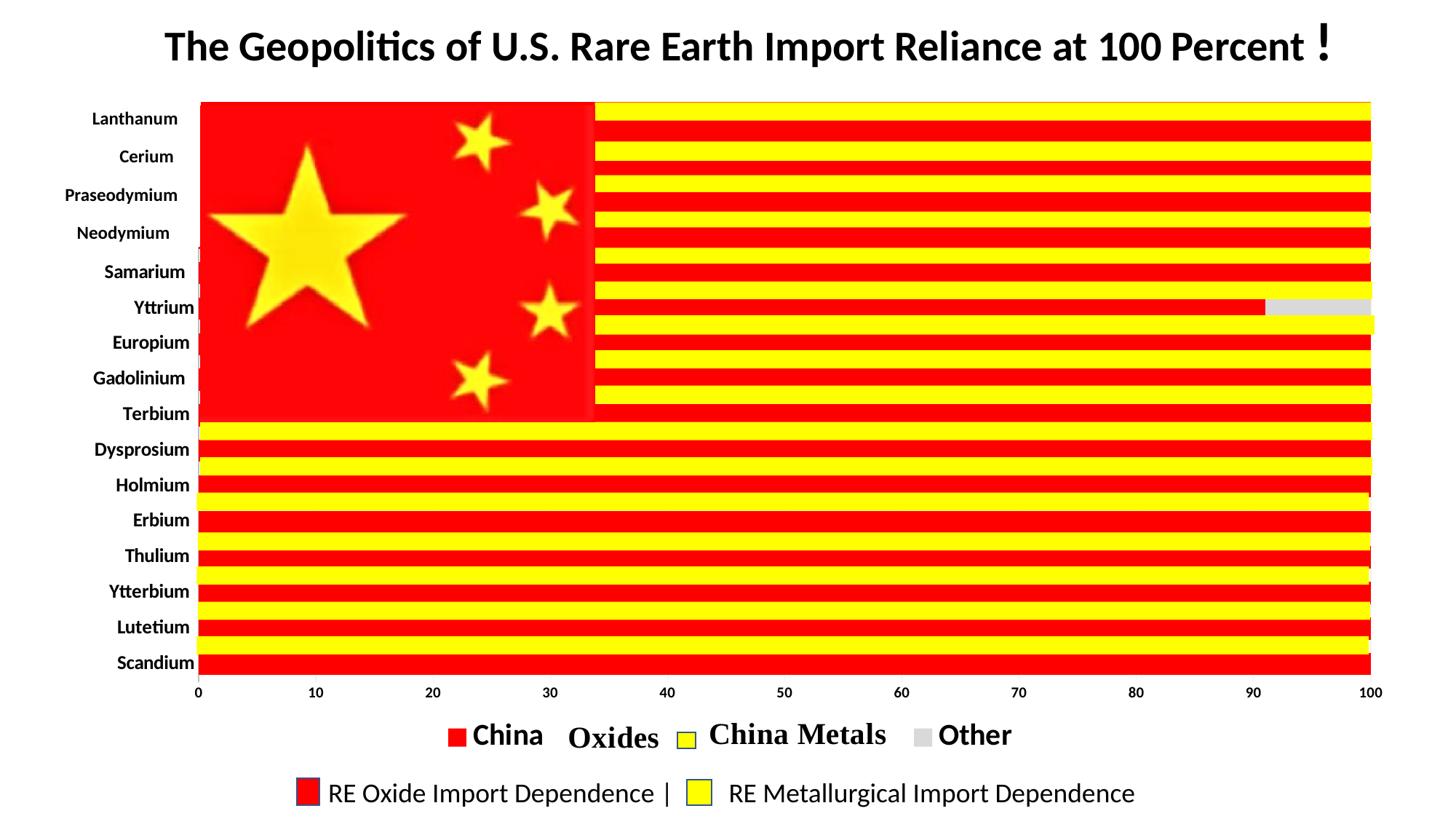
How many series does the chart legend list? 3 What is the China Oxides value for Lanthanum? 100 What kind of chart is shown on the slide? bar chart Which category has the lowest China Oxides value? Yttrium Is the China Oxides value for Yttrium greater or less than 100? less Which is larger, the China Oxides value for Cerium or for Yttrium? Cerium Which colour represents the China Metals series in the chart? yellow What is the title of the chart on the slide? The Geopolitics of U.S. Rare Earth Import Reliance at 100 Percent ! How many rare earth categories are listed on the vertical axis of the chart? 16 What is the China Oxides value for Scandium? 100 Which category has a grey 'Other' segment in its bar? Yttrium Is the China Oxides value for Yttrium greater or less than 80? greater